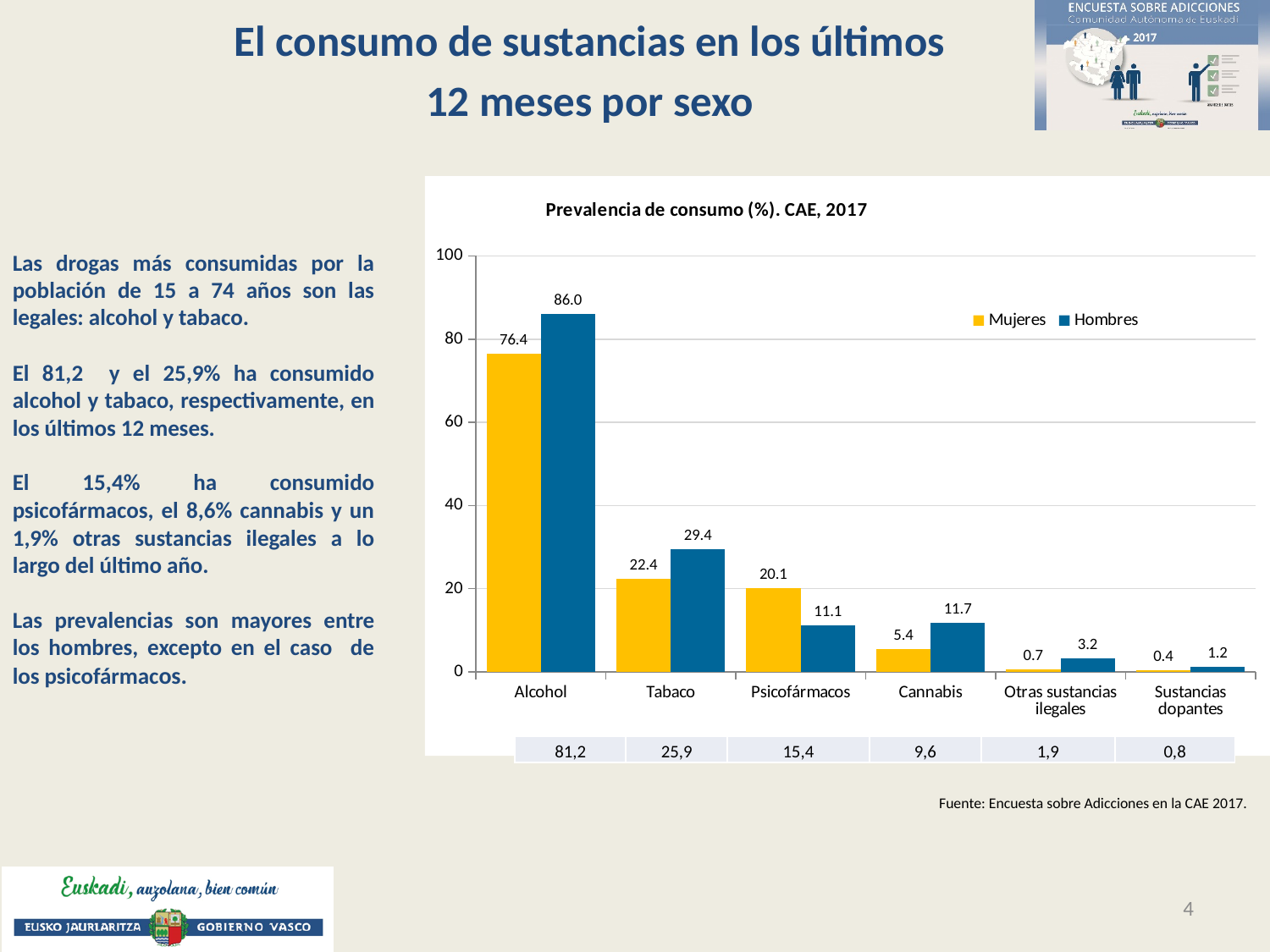
What is the value for Mujeres in the Sustancias dopantes category? 0.4 What is the title of the chart? Prevalencia de consumo (%). CAE, 2017 Which category has the lowest value for Hombres? Sustancias dopantes What is the value for Mujeres in the Psicofármacos category? 20.1 How many series does the legend list? 2 How many categories are shown on the x axis? 6 In the Psicofármacos category, which series has the larger value, Mujeres or Hombres? Mujeres What is the value for Hombres in the Alcohol category? 86.0 What is the difference between the Hombres and Mujeres values for Tabaco? 7.0 What is the value for Hombres in the Cannabis category? 11.7 What kind of chart is shown on the slide? Bar chart Which category has the highest value for Mujeres? Alcohol